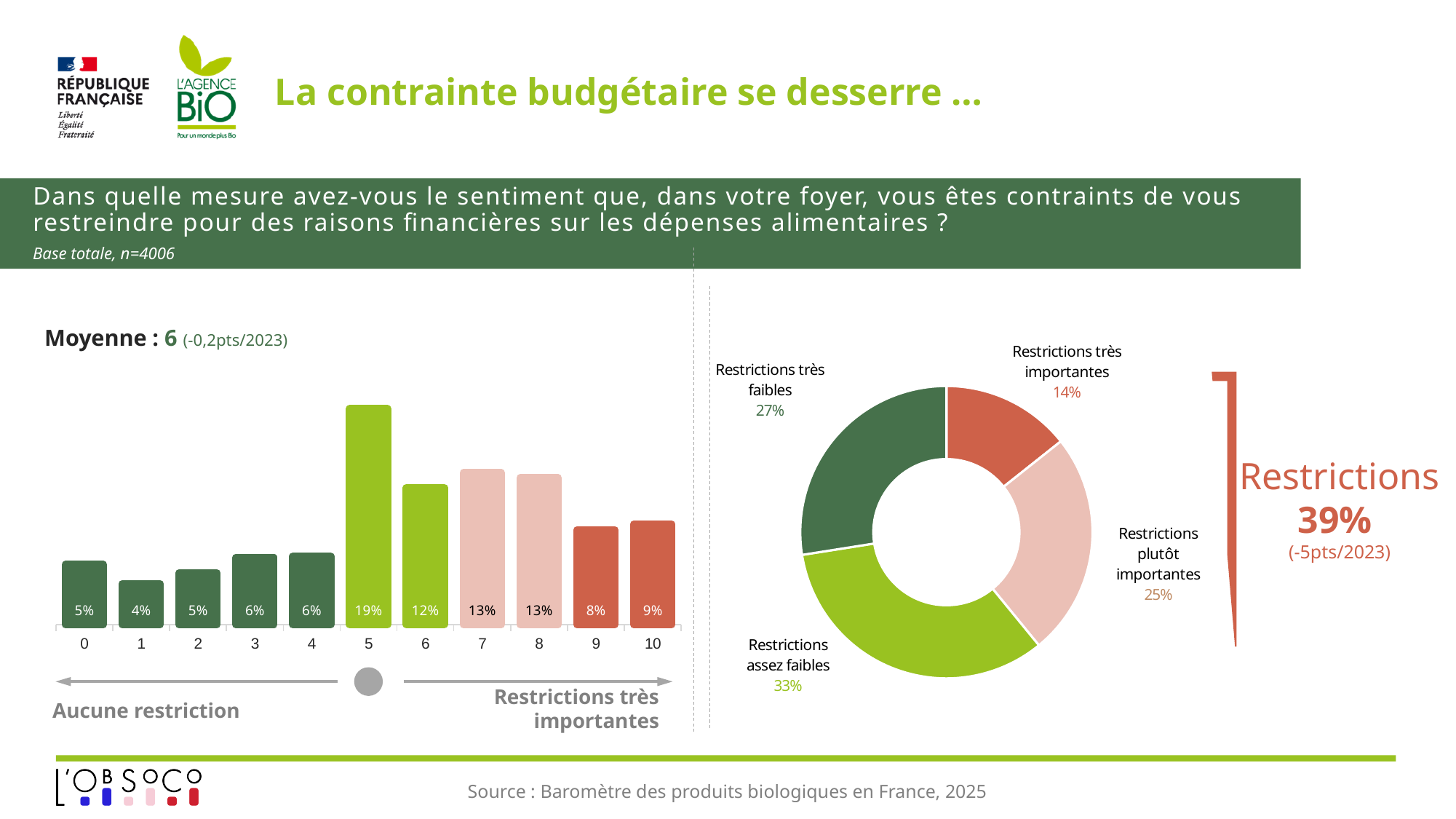
In the bar chart on the left, which scale value has the highest percentage? 5 What is the average (Moyenne) shown above the bar chart on the left? 6 In the bar chart on the left, which has a larger percentage, value 9 or value 10? 10 In the bar chart on the left, what percentage of respondents chose the value 5? 19% In the donut chart on the right, what share is labelled 'Restrictions assez faibles'? 33% In the bar chart on the left, which scale value has the lowest percentage? 1 In the donut chart on the right, what is the combined share of 'Restrictions plutôt importantes' and 'Restrictions très importantes'? 39% In the bar chart on the left, what percentage of respondents chose the value 10? 9% In the donut chart on the right, which category has the smallest share? Restrictions très importantes What type of chart is shown on the left side of the slide? Bar chart How many scale values (bars) are shown in the bar chart on the left? 11 In the bar chart on the left, what is the difference between the percentages for values 5 and 6? 7%